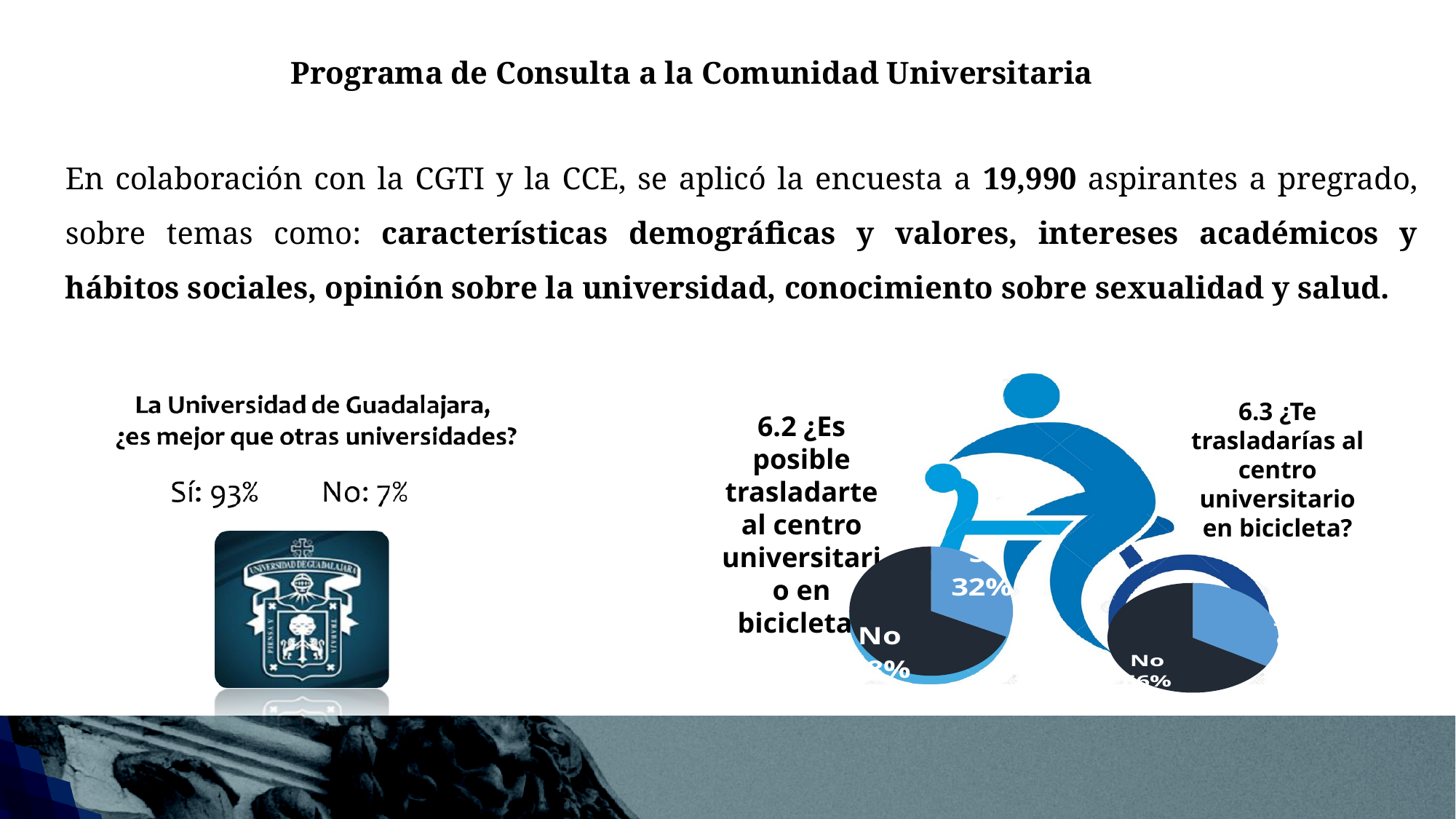
In the pie chart for 6.2 '¿Es posible trasladarte al centro universitario en bicicleta?', which answer has the larger slice, Sí or No? No How many slices does the pie chart for 6.3 '¿Te trasladarías al centro universitario en bicicleta?' have? 2 What is the title of the pie chart on the right side of the slide? 6.3 ¿Te trasladarías al centro universitario en bicicleta? What kind of chart is used for question 6.2 '¿Es posible trasladarte al centro universitario en bicicleta?'? Pie chart In the pie chart for 6.2 '¿Es posible trasladarte al centro universitario en bicicleta?', what percentage answered Sí? 32% How many pie charts are shown on the slide? 2 In the pie chart for 6.3 '¿Te trasladarías al centro universitario en bicicleta?', which answer has the larger slice, Sí or No? No How many slices does the pie chart for 6.2 '¿Es posible trasladarte al centro universitario en bicicleta?' have? 2